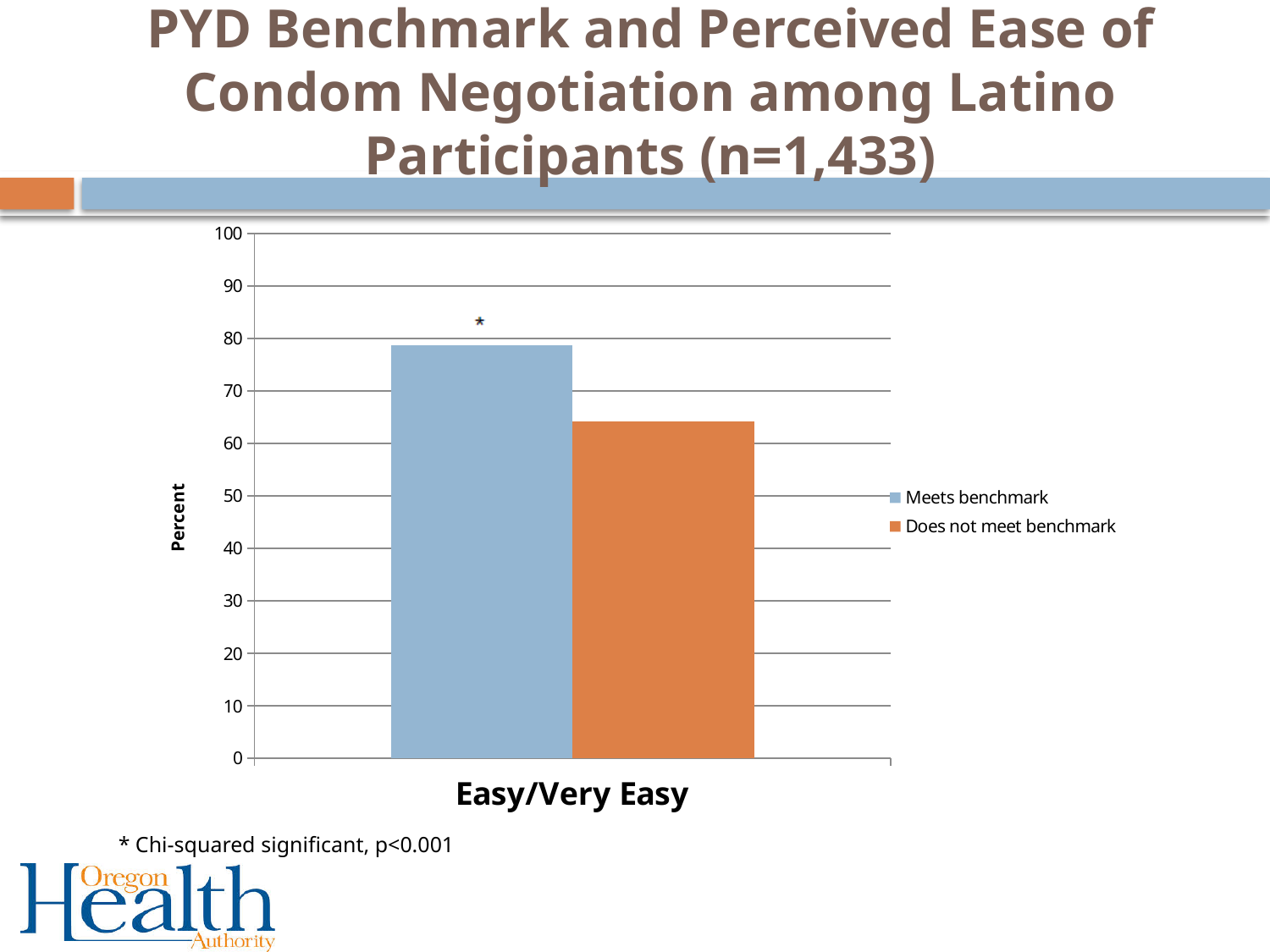
Which series has the taller bar for Easy/Very Easy, Meets benchmark or Does not meet benchmark? Meets benchmark Is the value for Does not meet benchmark greater or less than 60? greater What is the label on the y axis? Percent How many categories are shown on the x axis? 1 How many series does the legend list? 2 Which series has the lowest value for Easy/Very Easy? Does not meet benchmark Is the value for Does not meet benchmark greater or less than 70? less What is the label of the category on the x axis? Easy/Very Easy What kind of chart is shown on the slide? bar chart Is the value for Meets benchmark greater or less than 70? greater